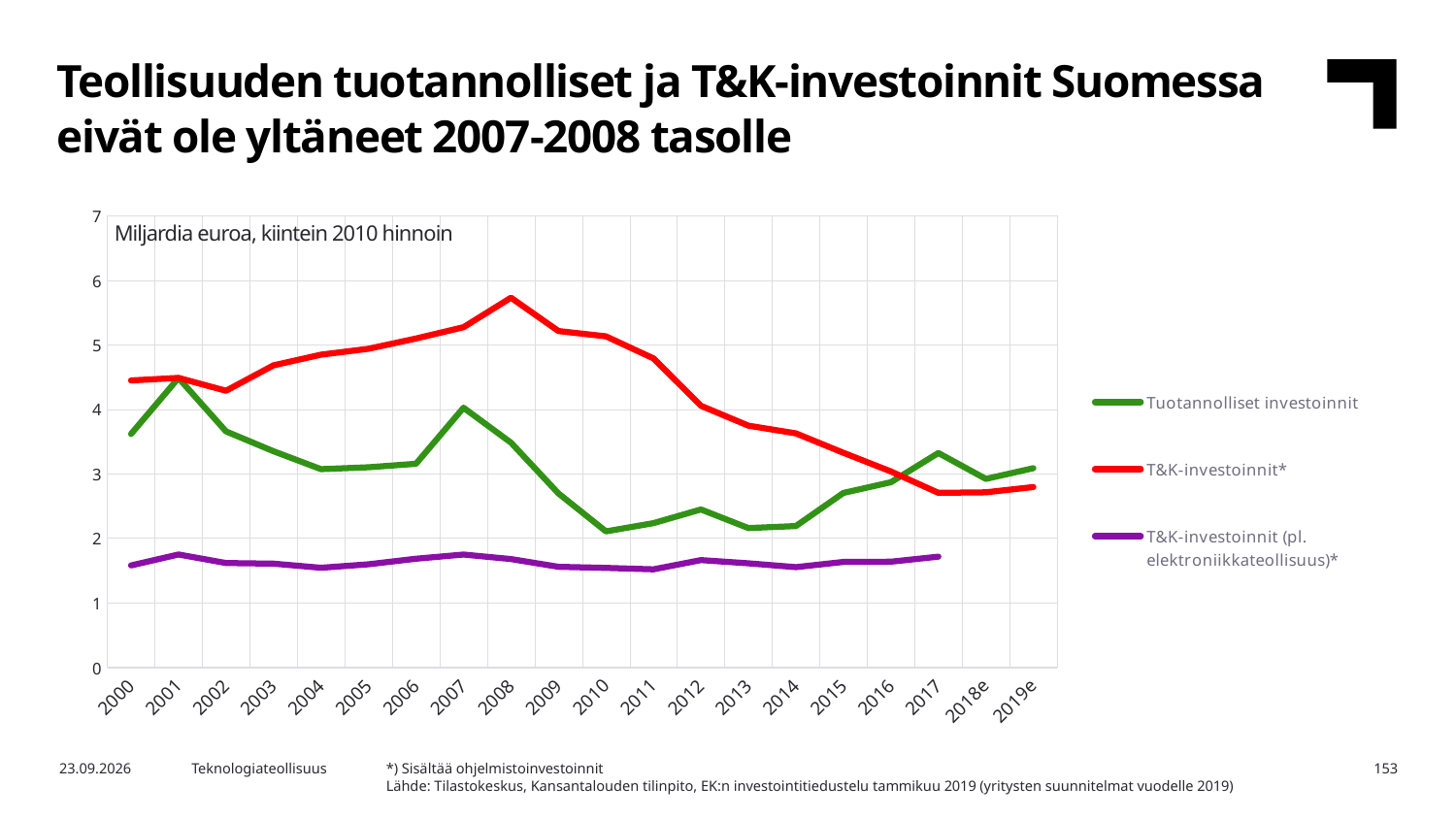
Is the value for T&K-investoinnit* in 2008 greater or less than 5? greater Does the T&K-investoinnit* series rise or fall from 2008 to 2017? fall Is the value for Tuotannolliset investoinnit in 2010 greater or less than 3? less In which year does the Tuotannolliset investoinnit series reach its highest value? 2001 In which year does the T&K-investoinnit* series reach its highest value? 2008 In 2017, which is larger: Tuotannolliset investoinnit or T&K-investoinnit*? Tuotannolliset investoinnit How many years are shown along the x axis? 20 What unit is stated in the label inside the chart area? Miljardia euroa, kiintein 2010 hinnoin What kind of chart is shown on the slide? line chart Is the value for T&K-investoinnit (pl. elektroniikkateollisuus)* in 2007 greater or less than 2? less How many series does the legend list? 3 In 2000, which is larger: Tuotannolliset investoinnit or T&K-investoinnit*? T&K-investoinnit*